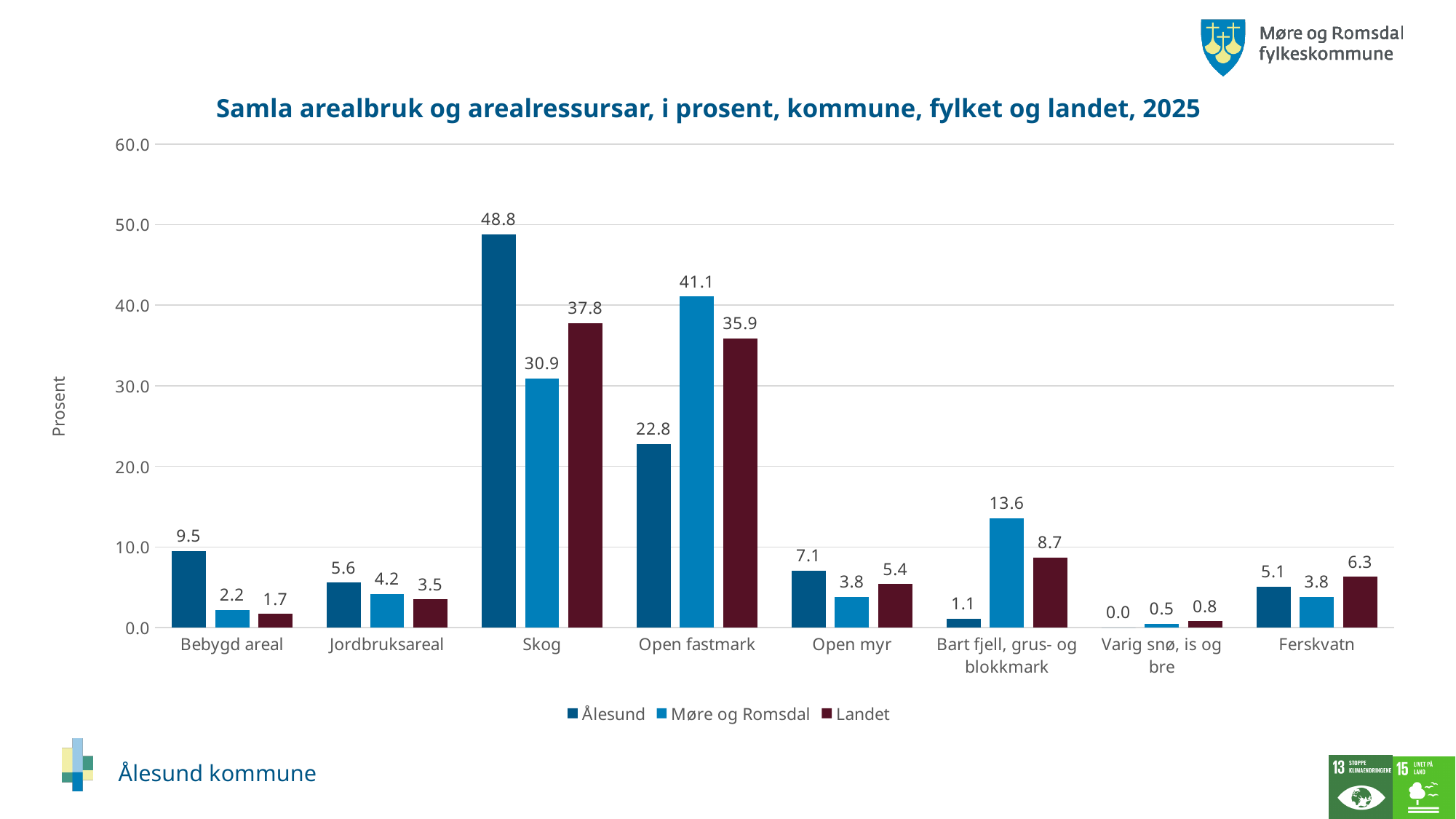
How many categories are shown on the x axis? 8 Is the value for Landet in Open fastmark greater or less than 30.0? greater What is the value for Ålesund in the Skog category? 48.8 How many series does the legend list? 3 What is the value for Landet in the Ferskvatn category? 6.3 Which category has the highest value for Ålesund? Skog What kind of chart is shown on the slide? bar chart What is the value for Møre og Romsdal in the Open fastmark category? 41.1 What is the label of the y axis? Prosent What is the difference between the Ålesund and Landet values for Skog? 11.0 Which category has the lowest value for Møre og Romsdal? Varig snø, is og bre Which is larger for Bart fjell, grus- og blokkmark: Møre og Romsdal or Landet? Møre og Romsdal